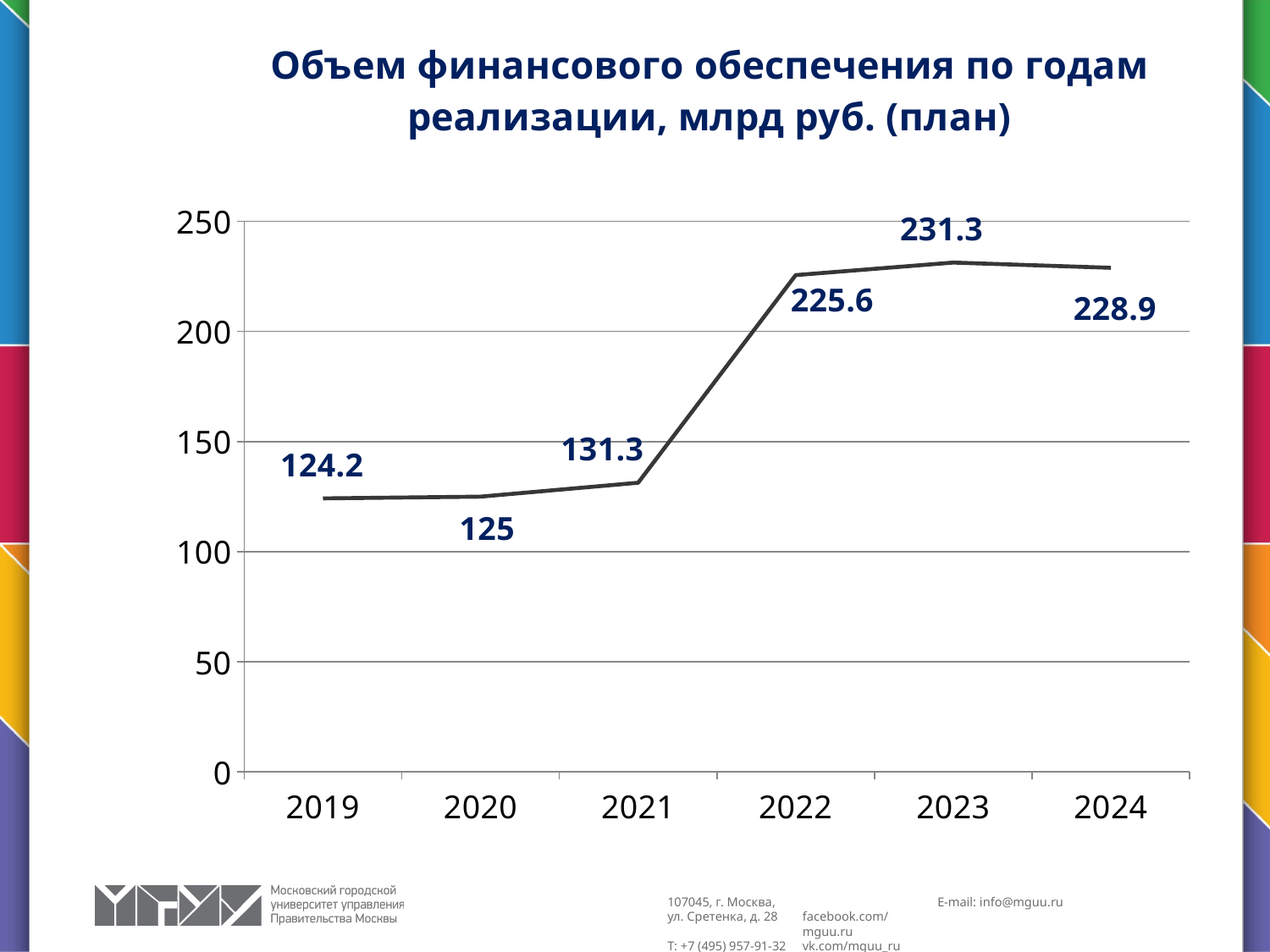
Which year has the lowest value? 2019 Is the value for 2021 greater or less than 150? less What is the value for 2024? 228.9 What is the difference between the values for 2022 and 2021? 94.3 What is the value for 2022? 225.6 What is the title of the chart? Объем финансового обеспечения по годам реализации, млрд руб. (план) What is the value for 2019? 124.2 Which year has the highest value? 2023 What kind of chart is shown on the slide? line chart How many years are plotted on the chart? 6 Which is larger, the value for 2023 or the value for 2024? 2023 Do the values generally rise or fall from 2019 to 2023? rise